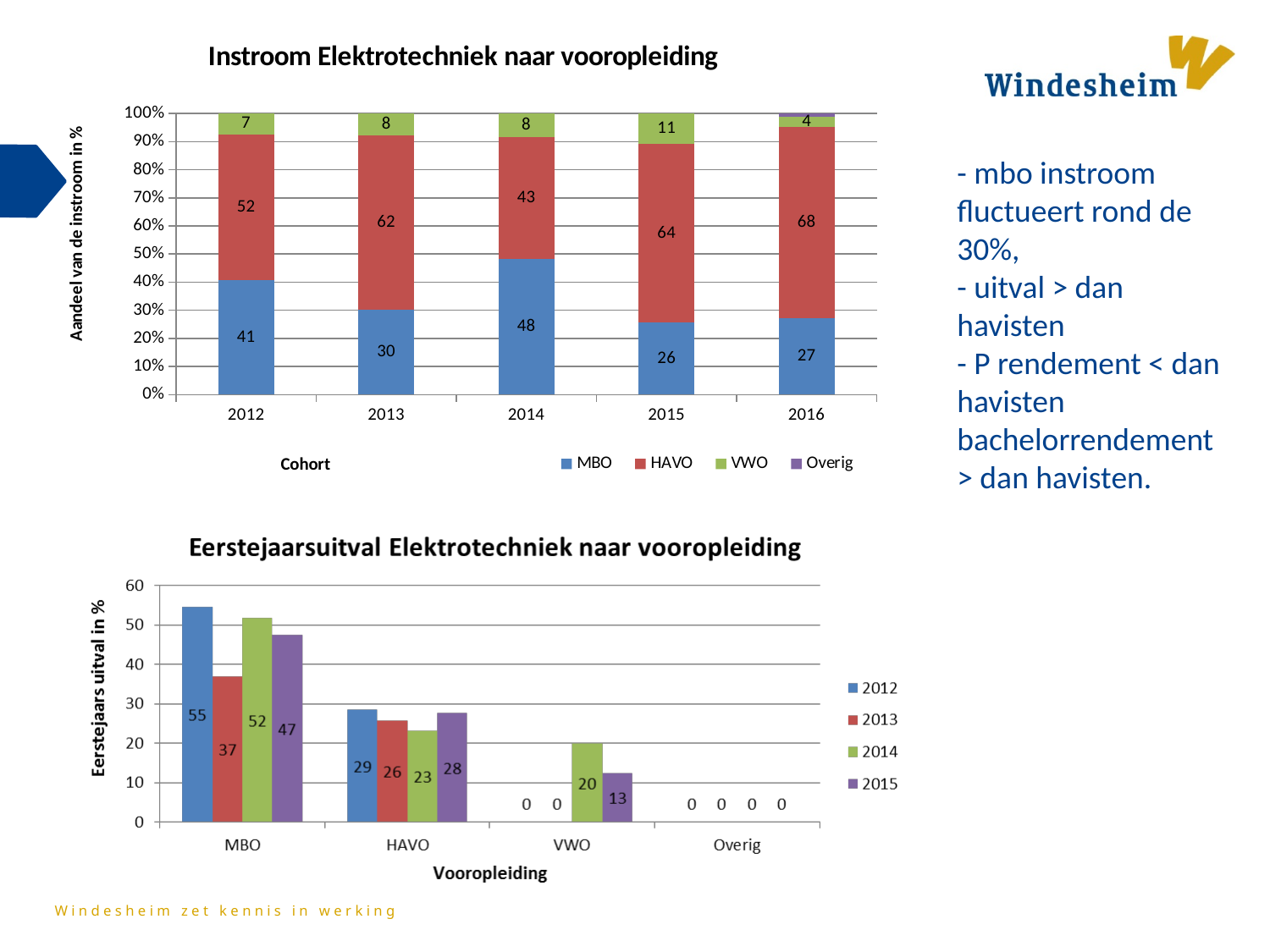
In the bottom chart 'Eerstejaarsuitval Elektrotechniek naar vooropleiding', which is larger for HAVO: the 2012 value or the 2014 value? 2012 In the top chart 'Instroom Elektrotechniek naar vooropleiding', what is the MBO value for the 2014 cohort? 48 In the bottom chart 'Eerstejaarsuitval Elektrotechniek naar vooropleiding', what is the label of the y axis? Eerstejaars uitval in % In the top chart 'Instroom Elektrotechniek naar vooropleiding', how many series does the legend list? 4 In the top chart 'Instroom Elektrotechniek naar vooropleiding', which cohort has the highest VWO value? 2015 In the bottom chart 'Eerstejaarsuitval Elektrotechniek naar vooropleiding', what is the difference between the 2014 and 2015 values for VWO? 7 In the bottom chart 'Eerstejaarsuitval Elektrotechniek naar vooropleiding', what is the 2013 value for MBO? 37 What kind of chart is the bottom chart 'Eerstejaarsuitval Elektrotechniek naar vooropleiding'? Bar chart In the bottom chart 'Eerstejaarsuitval Elektrotechniek naar vooropleiding', which year has the highest value for MBO? 2012 In the top chart 'Instroom Elektrotechniek naar vooropleiding', what is the HAVO value for the 2016 cohort? 68 In the top chart 'Instroom Elektrotechniek naar vooropleiding', what is the difference between the HAVO values for 2013 and 2014? 19 In the top chart 'Instroom Elektrotechniek naar vooropleiding', how many cohorts are shown on the x axis? 5